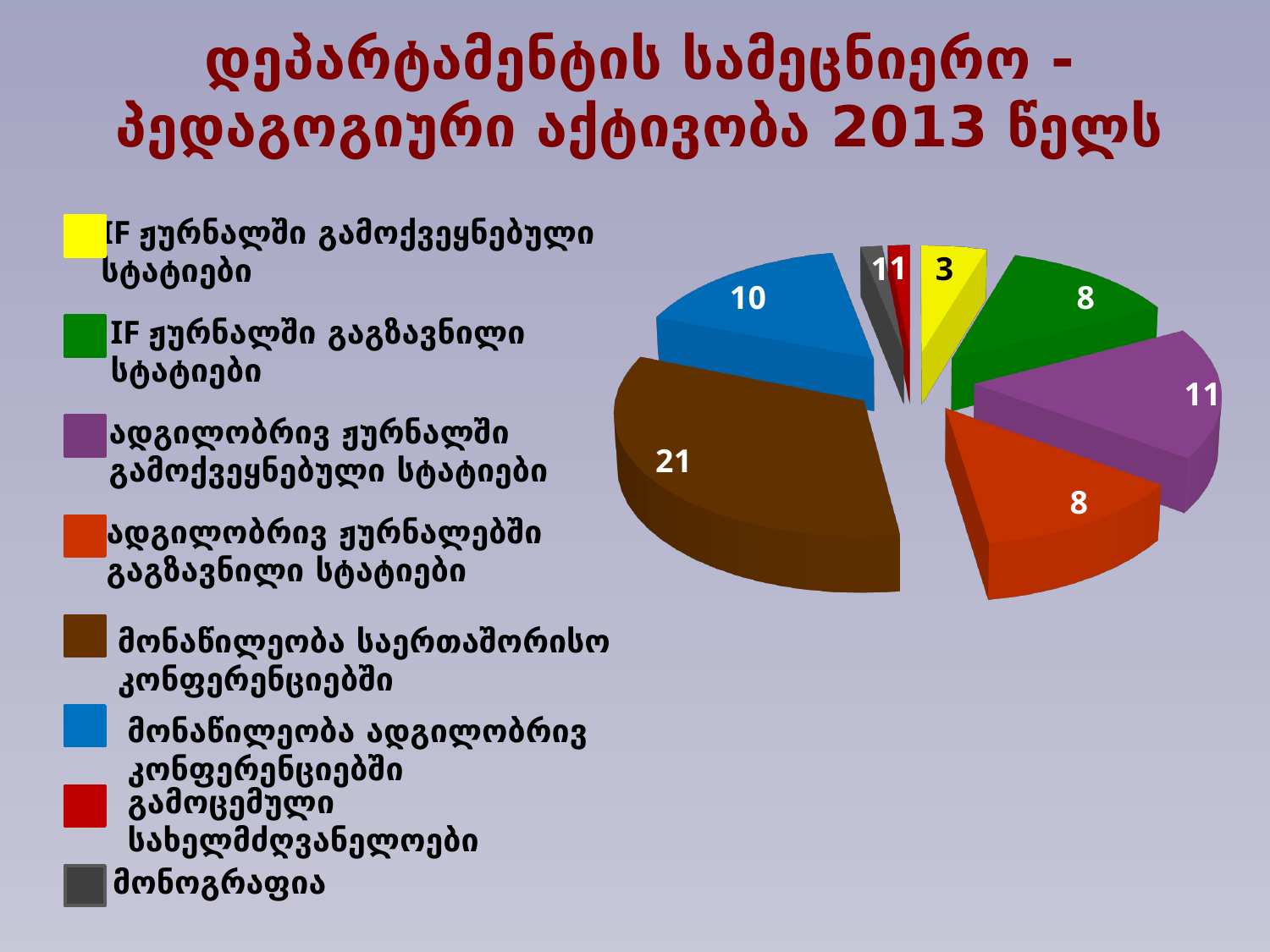
What is the value for მონაწილეობა საერთაშორისო კონფერენციებში (brown slice)? 21 What colour is the slice for მონოგრაფია? gray What is the value for IF ჟურნალში გამოქვეყნებული სტატიები (yellow slice)? 3 What kind of chart is shown on the slide? pie chart What is the value for ადგილობრივ ჟურნალში გამოქვეყნებული სტატიები (purple slice)? 11 What is the difference between the value for მონაწილეობა საერთაშორისო კონფერენციებში and the value for მონაწილეობა ადგილობრივ კონფერენციებში? 11 Which category has the largest slice in the pie chart? მონაწილეობა საერთაშორისო კონფერენციებში Which is larger: the value for IF ჟურნალში გაგზავნილი სტატიები or the value for IF ჟურნალში გამოქვეყნებული სტატიები? IF ჟურნალში გაგზავნილი სტატიები How many slices does the pie chart have? 8 What is the total of all the values shown in the pie chart? 63 What share of the pie does მონაწილეობა საერთაშორისო კონფერენციებში represent? 33.3% What is the value for მონაწილეობა ადგილობრივ კონფერენციებში (blue slice)? 10